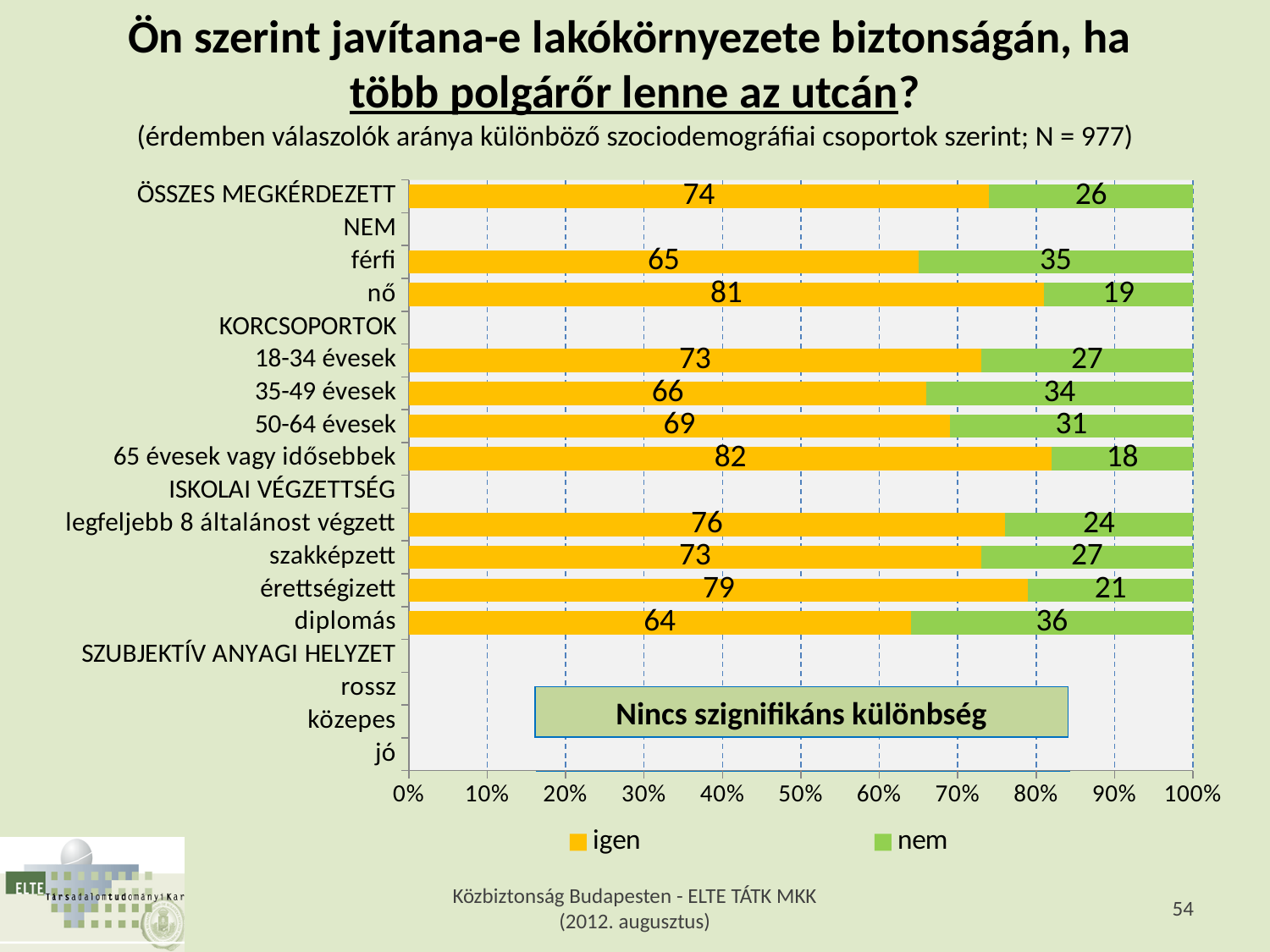
What is the difference between the 'igen' values for 'nő' and 'férfi'? 16 What text is shown in the box over the 'rossz', 'közepes' and 'jó' rows? Nincs szignifikáns különbség Which series is shown in green? nem What is the 'igen' value for 'ÖSSZES MEGKÉRDEZETT'? 74 How many series does the legend list? 2 What kind of chart is shown on the slide? stacked bar chart What is the total of the stacked bar for 'érettségizett'? 100 What is the 'nem' value for 'diplomás'? 36 Which has a larger 'nem' value, '35-49 évesek' or '50-64 évesek'? 35-49 évesek Which category has the highest 'igen' value? 65 évesek vagy idősebbek What is the 'igen' value for 'nő'? 81 Which category has the lowest 'igen' value? diplomás